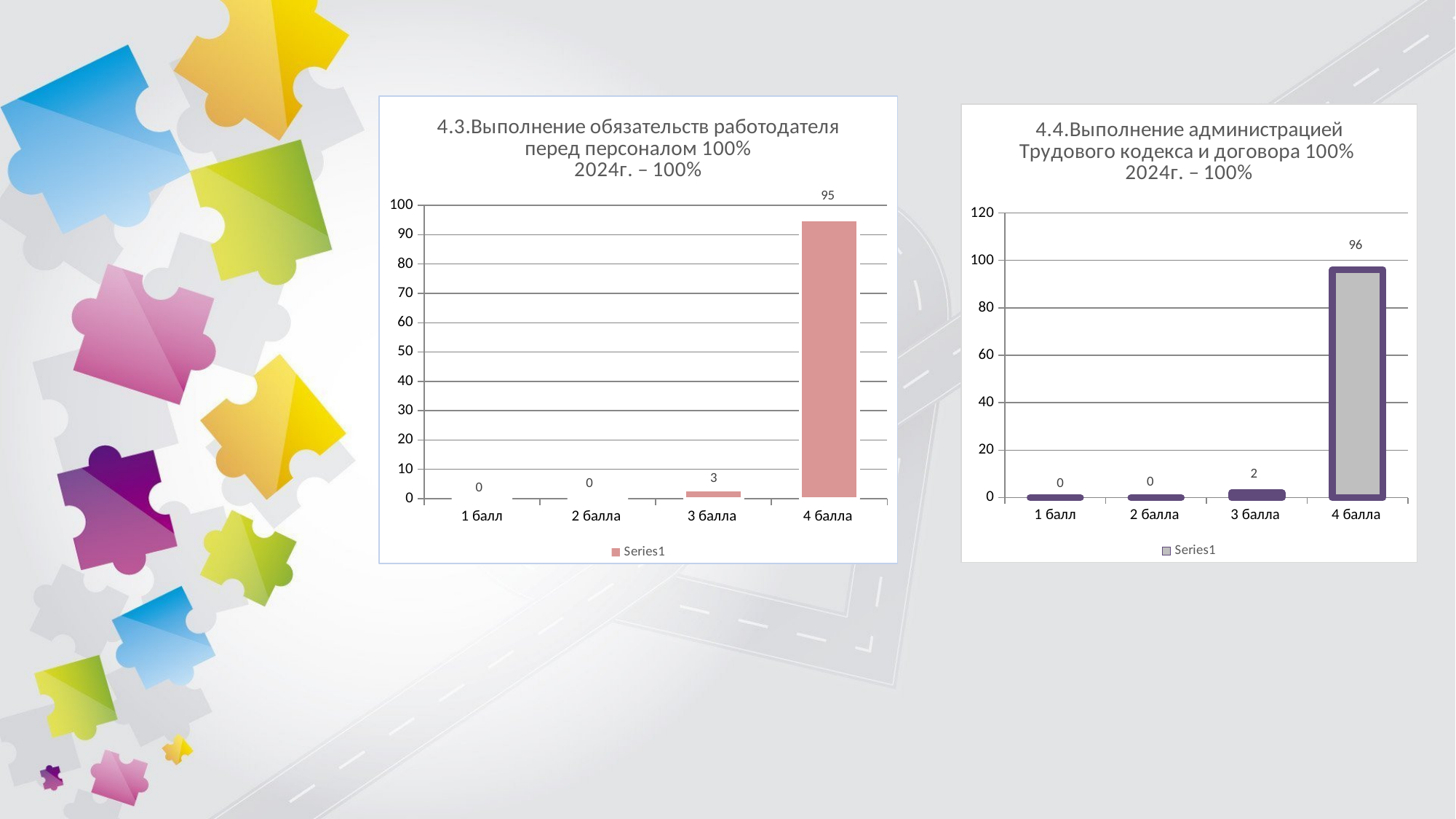
In the right chart (4.4), what is the value for 3 балла? 2 Which is larger: the value for 4 балла in the left chart (4.3) or the value for 4 балла in the right chart (4.4)? The right chart (4.4), 96 In the left chart (4.3), what is the difference between the values for 4 балла and 3 балла? 92 In the left chart (4.3), what is the value for 3 балла? 3 How many categories are shown on the x axis of the left chart (4.3)? 4 In the left chart (4.3), which category has the highest value? 4 балла In the right chart (4.4), what is the difference between the values for 4 балла and 3 балла? 94 In the left chart (4.3), what is the value for 4 балла? 95 What type of chart is the right chart (4.4)? Bar chart In the right chart (4.4), which category has the highest value? 4 балла How many series does the legend of the left chart (4.3) list? 1 In the right chart (4.4), what is the value for 4 балла? 96